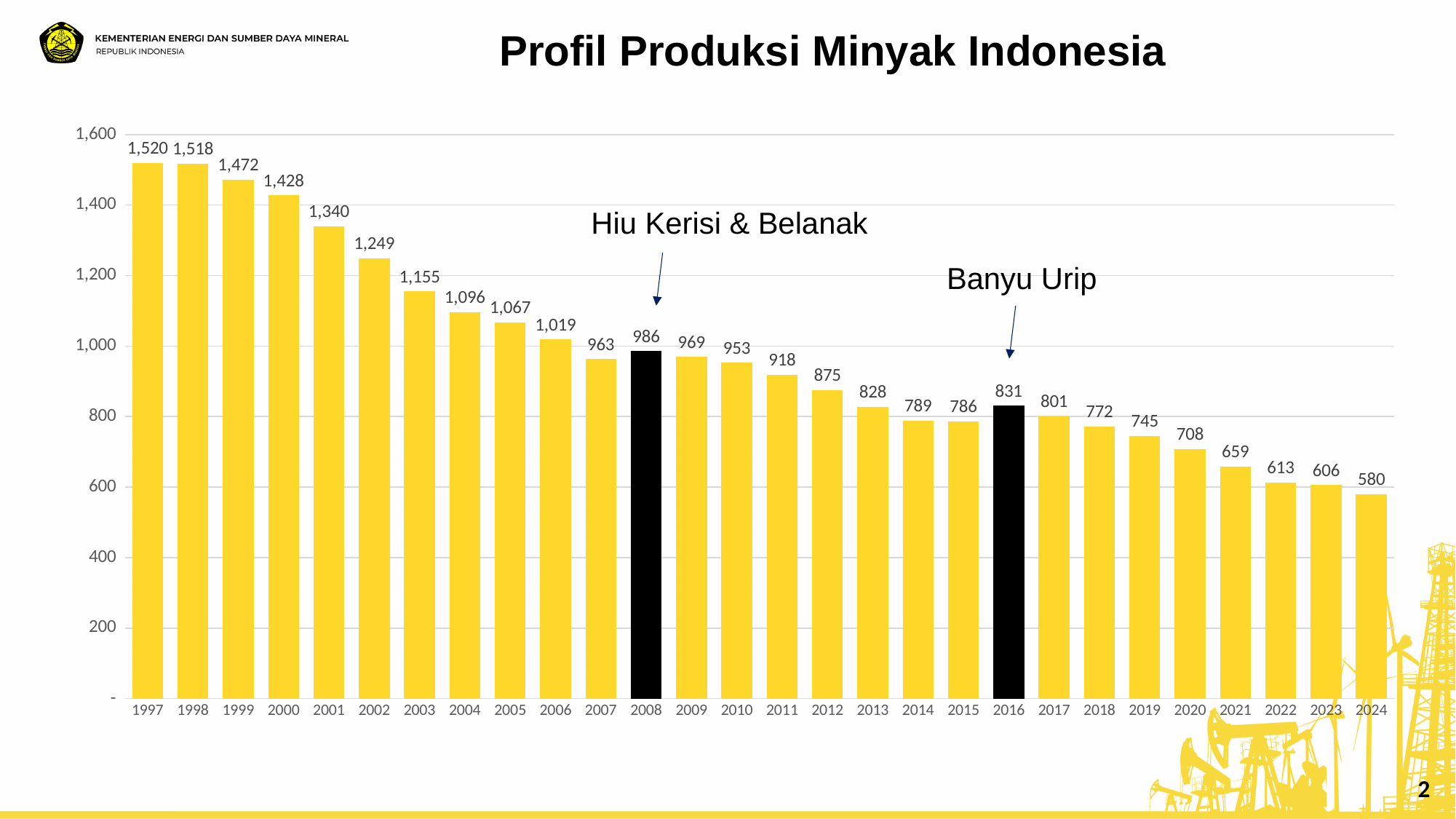
What is the value for 1997? 1,520 What is the value for 2016? 831 Which label is attached to the black bar for 2016? Banyu Urip Which year has the lowest value? 2024 What is the value for 2008? 986 Which is larger, the value for 2012 or the value for 2017? 2012 What kind of chart is shown on the slide? bar chart What is the difference between the values for 2008 and 2016? 155 What is the title of the chart? Profil Produksi Minyak Indonesia Do the values generally rise or fall from 1997 to 2024? fall Which year has the highest value? 1997 How many years are shown on the x axis? 28